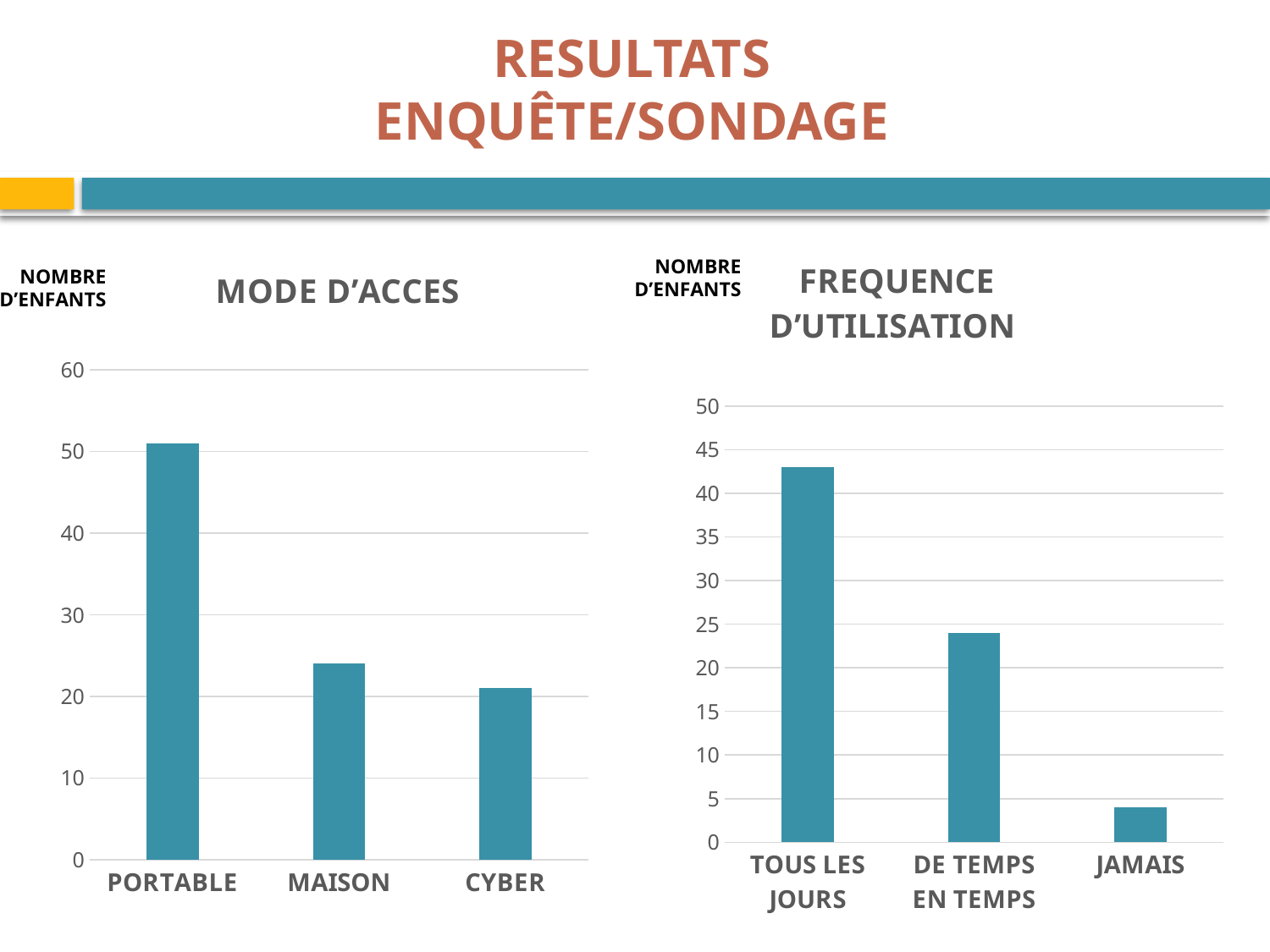
On the FREQUENCE D'UTILISATION chart, is the value for TOUS LES JOURS greater or less than 40? greater On the MODE D'ACCES chart, how many categories are shown? 3 On the MODE D'ACCES chart, is the value for MAISON greater or less than 30? less On the MODE D'ACCES chart, which category has the highest value? PORTABLE On the FREQUENCE D'UTILISATION chart, which category has the lowest value? JAMAIS On the MODE D'ACCES chart, which is larger, PORTABLE or MAISON? PORTABLE What is the label on the vertical axis of the MODE D'ACCES chart? NOMBRE D'ENFANTS On the FREQUENCE D'UTILISATION chart, is the value for JAMAIS greater or less than 5? less What type of chart is the FREQUENCE D'UTILISATION chart? bar chart On the FREQUENCE D'UTILISATION chart, which category has the highest value? TOUS LES JOURS